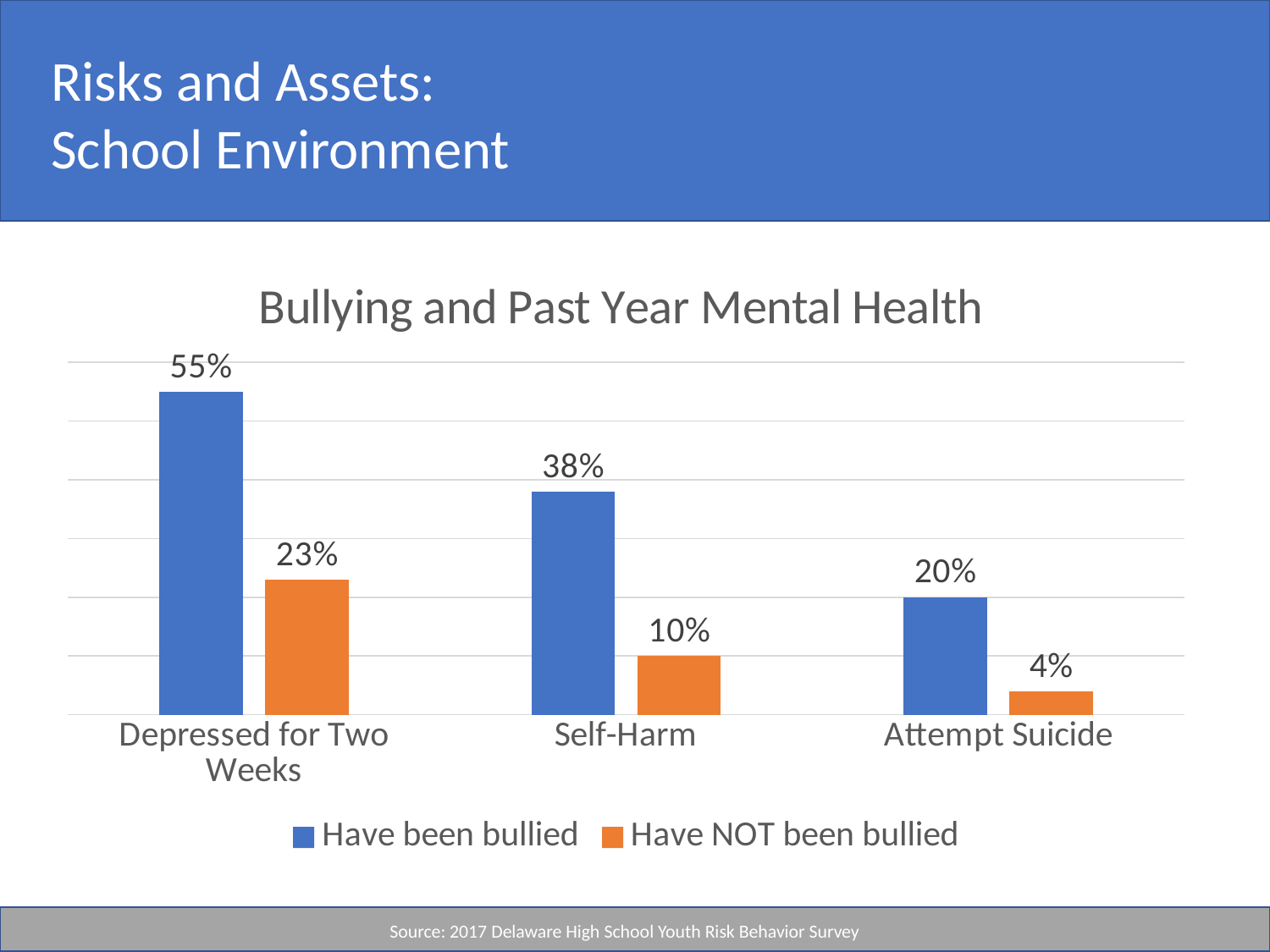
What is the title of the chart? Bullying and Past Year Mental Health What is the value for 'Have NOT been bullied' in the Self-Harm category? 10% How many categories are shown on the x axis? 3 What is the value for 'Have been bullied' in the Depressed for Two Weeks category? 55% Which is larger: 'Have NOT been bullied' for Depressed for Two Weeks or 'Have been bullied' for Attempt Suicide? Have NOT been bullied for Depressed for Two Weeks What is the difference between 'Have been bullied' and 'Have NOT been bullied' in the Self-Harm category? 28% Which category has the lowest value for 'Have NOT been bullied'? Attempt Suicide What is the value for 'Have NOT been bullied' in the Attempt Suicide category? 4% Which category has the highest value for 'Have been bullied'? Depressed for Two Weeks How many series does the legend list? 2 What kind of chart is shown on the slide? Bar chart What is the difference between 'Have been bullied' and 'Have NOT been bullied' in the Depressed for Two Weeks category? 32%